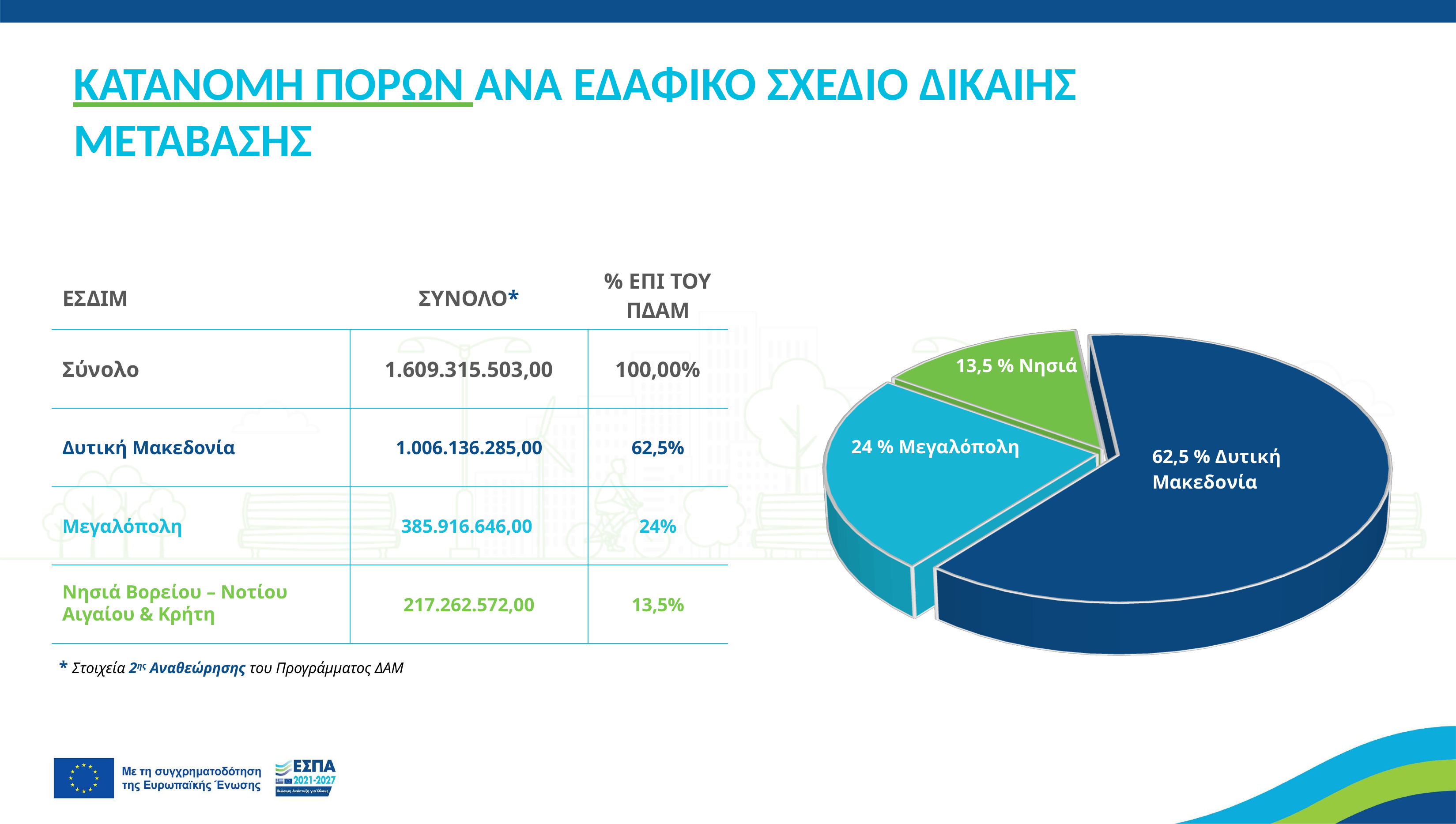
What kind of chart is shown on the slide? Pie chart Which slice of the pie chart is the smallest? Νησιά What share of the pie does Νησιά hold? 13,5 % By how many percentage points does the Δυτική Μακεδονία slice exceed the Μεγαλόπολη slice? 38,5 What colour is the Νησιά slice in the pie chart? Green Which is larger in the pie chart, Μεγαλόπολη or Νησιά? Μεγαλόπολη By how many percentage points does the Μεγαλόπολη slice exceed the Νησιά slice? 10,5 What colour is the Δυτική Μακεδονία slice in the pie chart? Dark blue What share of the pie does Δυτική Μακεδονία hold? 62,5 % How many slices does the pie chart have? 3 What share of the pie does Μεγαλόπολη hold? 24 % Which slice of the pie chart is the largest? Δυτική Μακεδονία